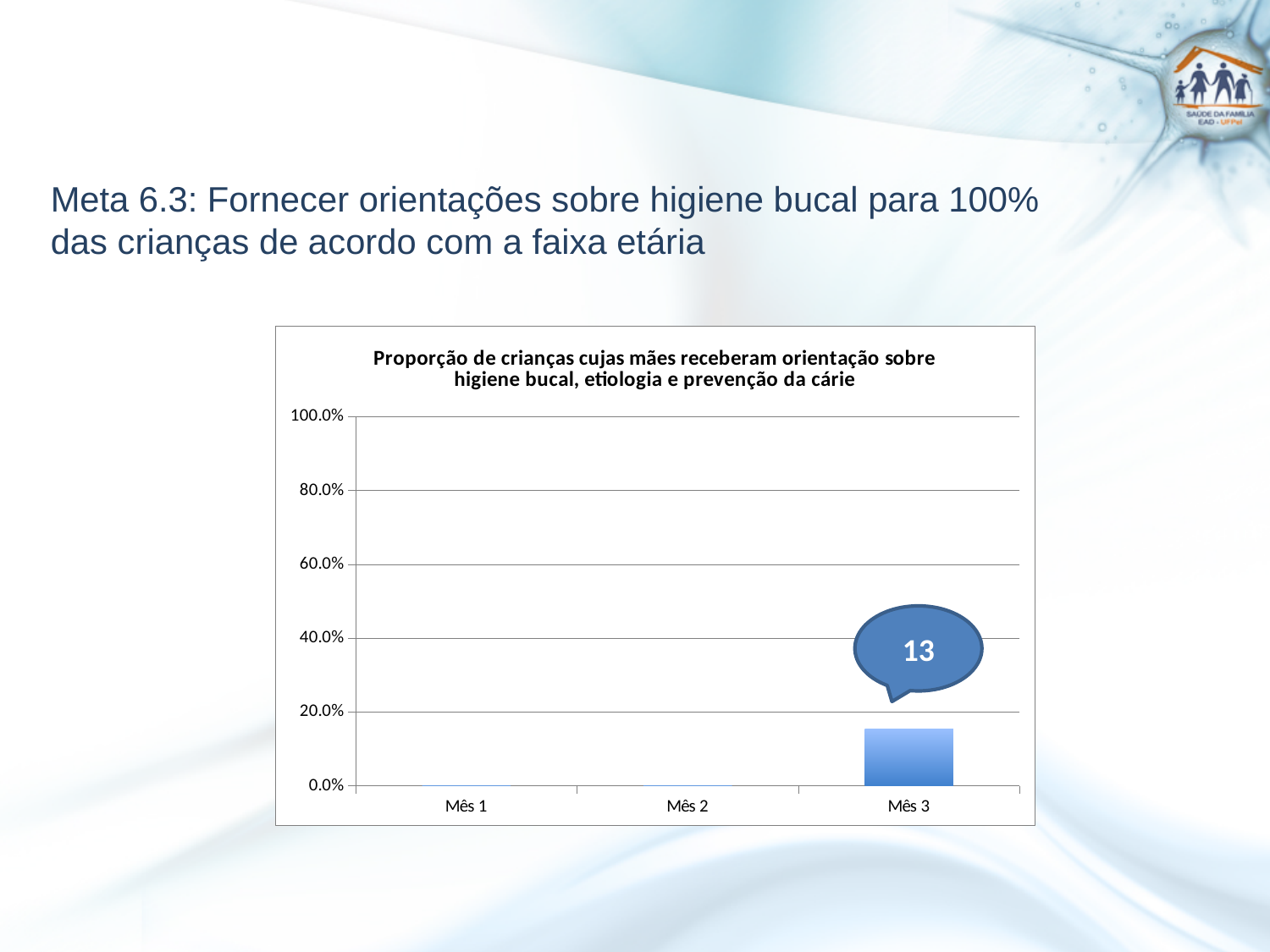
What is the title of the chart? Proporção de crianças cujas mães receberam orientação sobre higiene bucal, etiologia e prevenção da cárie Which month has the highest proportion in the chart? Mês 3 Do the values rise or fall from Mês 1 to Mês 3? rise How many months (categories) are shown on the x axis of the chart? 3 Is the value for Mês 3 greater or less than 20.0%? less Is the value for Mês 3 greater or less than 40.0%? less What is the value shown for Mês 1? 0.0% What type of chart is shown on the slide? bar chart Which is larger, the value for Mês 1 or the value for Mês 3? Mês 3 What is the highest value labelled on the y axis of the chart? 100.0% What number is written in the callout bubble above the Mês 3 bar? 13